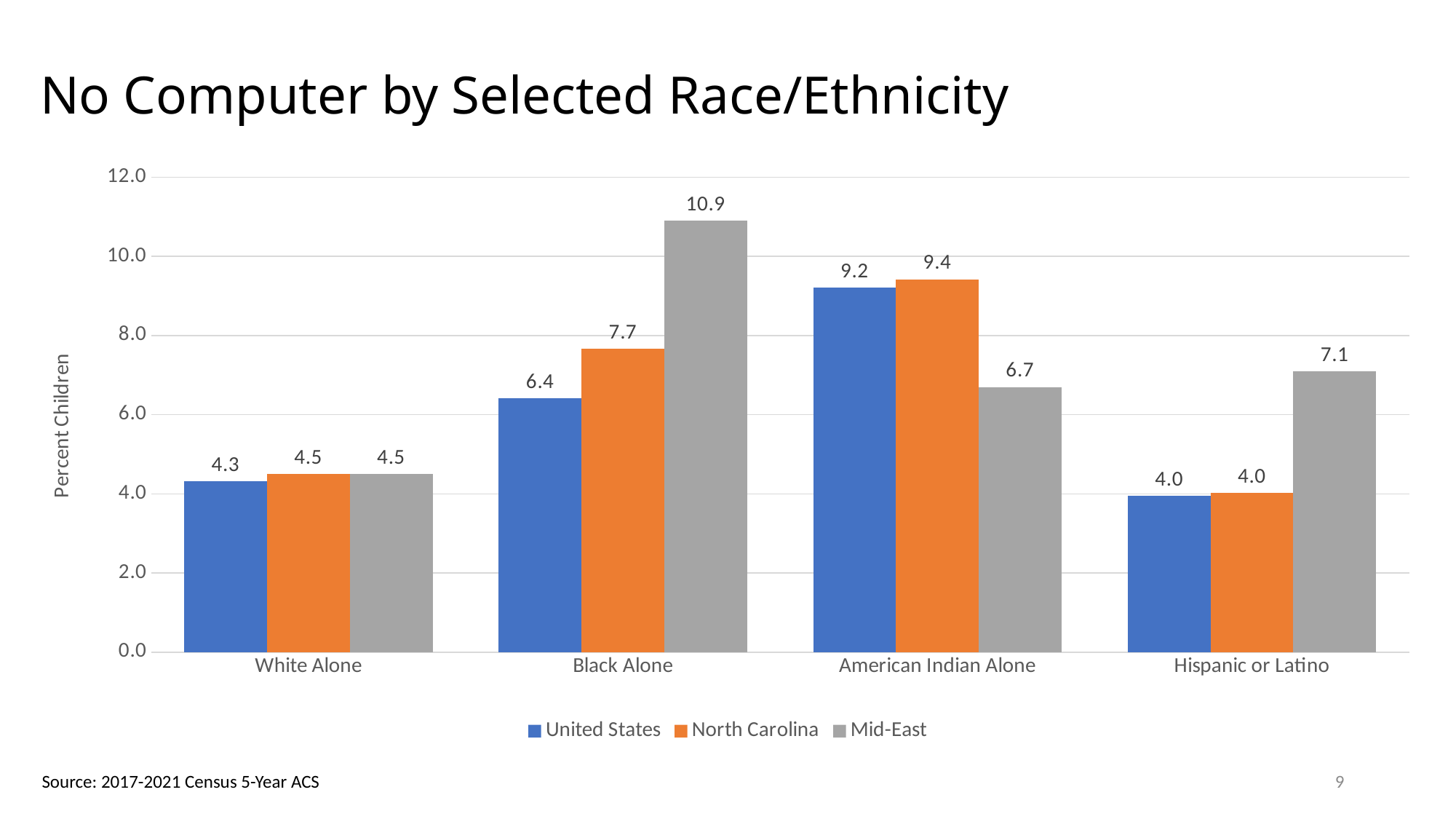
What kind of chart is shown on the slide? bar chart What is the label of the vertical axis? Percent Children What is the difference between the Mid-East and United States values for Black Alone? 4.5 Which category has the highest Mid-East value? Black Alone What is the United States value for American Indian Alone? 9.2 Which category has the lowest United States value? Hispanic or Latino How many series does the legend list? 3 What is the Mid-East value for Black Alone? 10.9 Which is larger for American Indian Alone: the North Carolina value or the Mid-East value? North Carolina Is the Mid-East value for Hispanic or Latino greater or less than 6.0? greater How many race/ethnicity categories are shown on the x axis? 4 What is the North Carolina value for Hispanic or Latino? 4.0